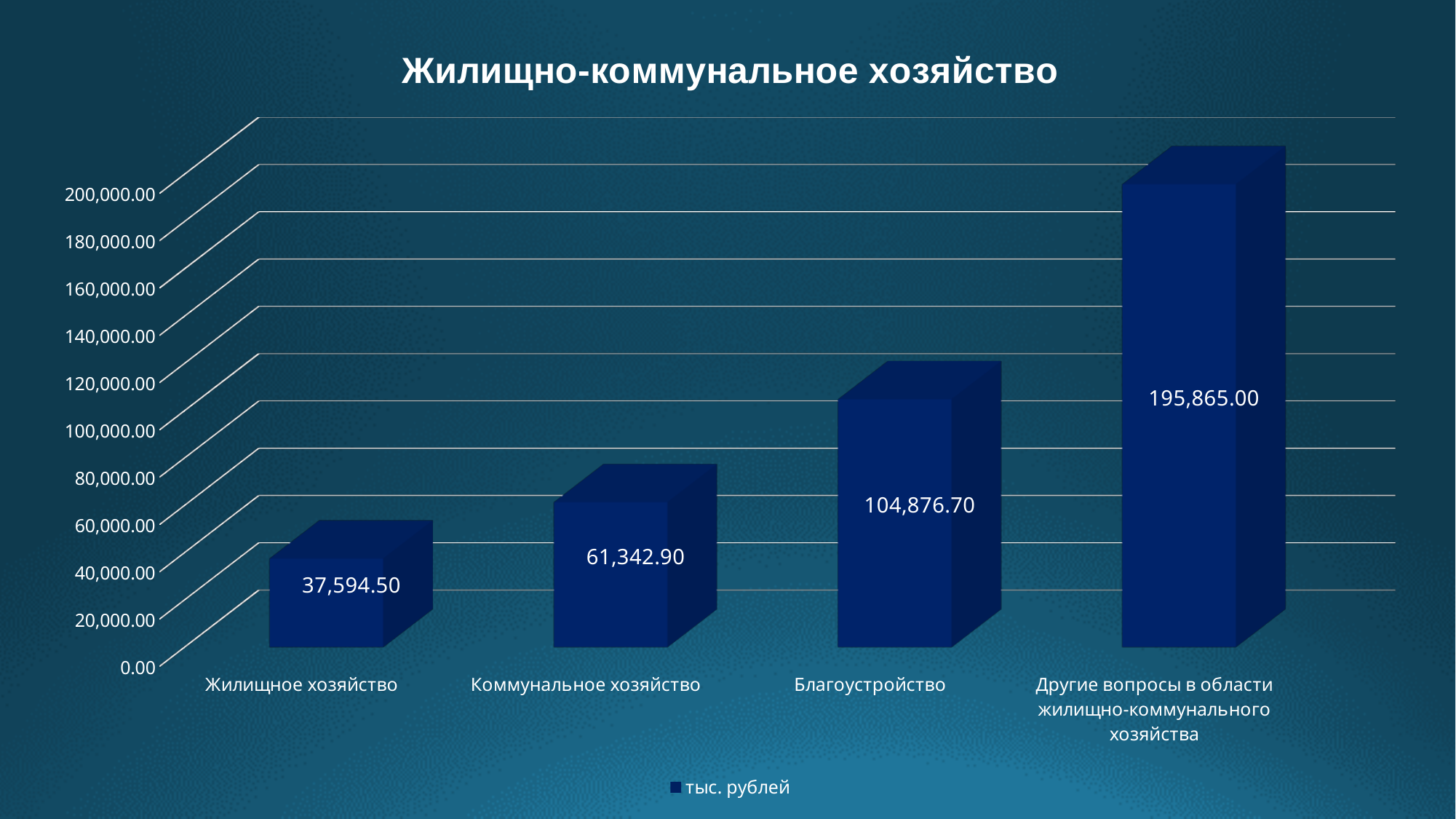
What is the value for Благоустройство? 104,876.70 What is the value for Жилищное хозяйство? 37,594.50 What is the value for Коммунальное хозяйство? 61,342.90 How many categories are shown in the chart? 4 What is the difference between the values for Благоустройство and Коммунальное хозяйство? 43,533.80 Is the value for Благоустройство greater or less than 100,000.00? greater Which category has the highest value? Другие вопросы в области жилищно-коммунального хозяйства What is the legend entry of the chart? тыс. рублей What is the value for Другие вопросы в области жилищно-коммунального хозяйства? 195,865.00 Which category has the lowest value? Жилищное хозяйство What kind of chart is shown on the slide? bar chart Which is larger, the value for Коммунальное хозяйство or the value for Жилищное хозяйство? Коммунальное хозяйство